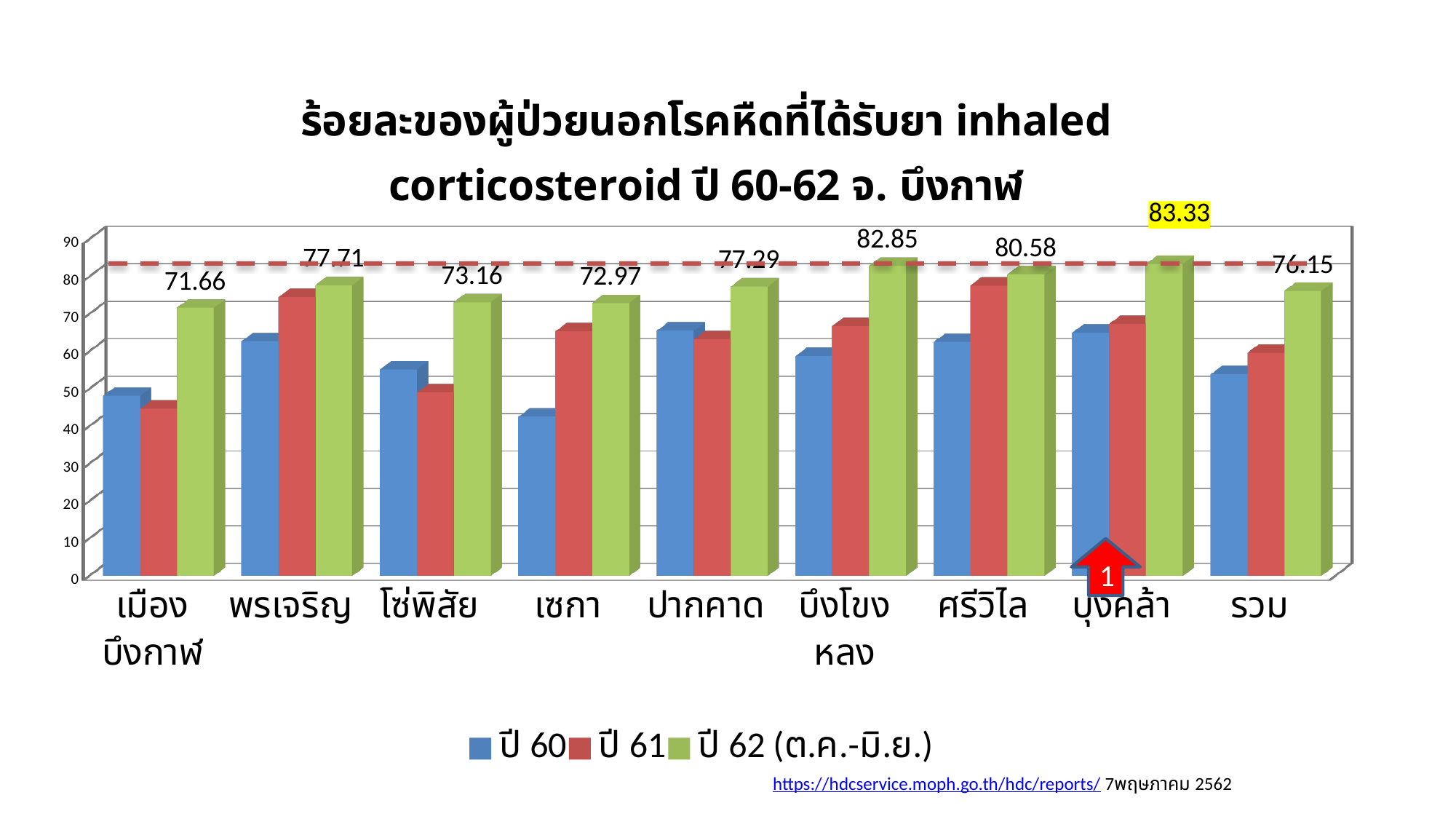
What is the value for ปี 62 (ต.ค.-มิ.ย.) in รวม? 76.15 Is the value for ปี 60 in ปากคาด greater or less than 60? greater How many categories are shown on the x axis? 9 Is the value for ปี 60 in เซกา greater or less than 50? less What is the value for ปี 62 (ต.ค.-มิ.ย.) in บึงโขงหลง? 82.85 What kind of chart is shown on the slide? Bar chart What is the difference between the ปี 62 (ต.ค.-มิ.ย.) values for บุ่งคล้า and เมืองบึงกาฬ? 11.67 Which is larger for ปี 62 (ต.ค.-มิ.ย.): พรเจริญ or โซ่พิสัย? พรเจริญ Which category has the highest value for ปี 62 (ต.ค.-มิ.ย.)? บุ่งคล้า Which category has the lowest value for ปี 62 (ต.ค.-มิ.ย.)? เมืองบึงกาฬ What is the value for ปี 62 (ต.ค.-มิ.ย.) in บุ่งคล้า? 83.33 How many series does the legend list? 3